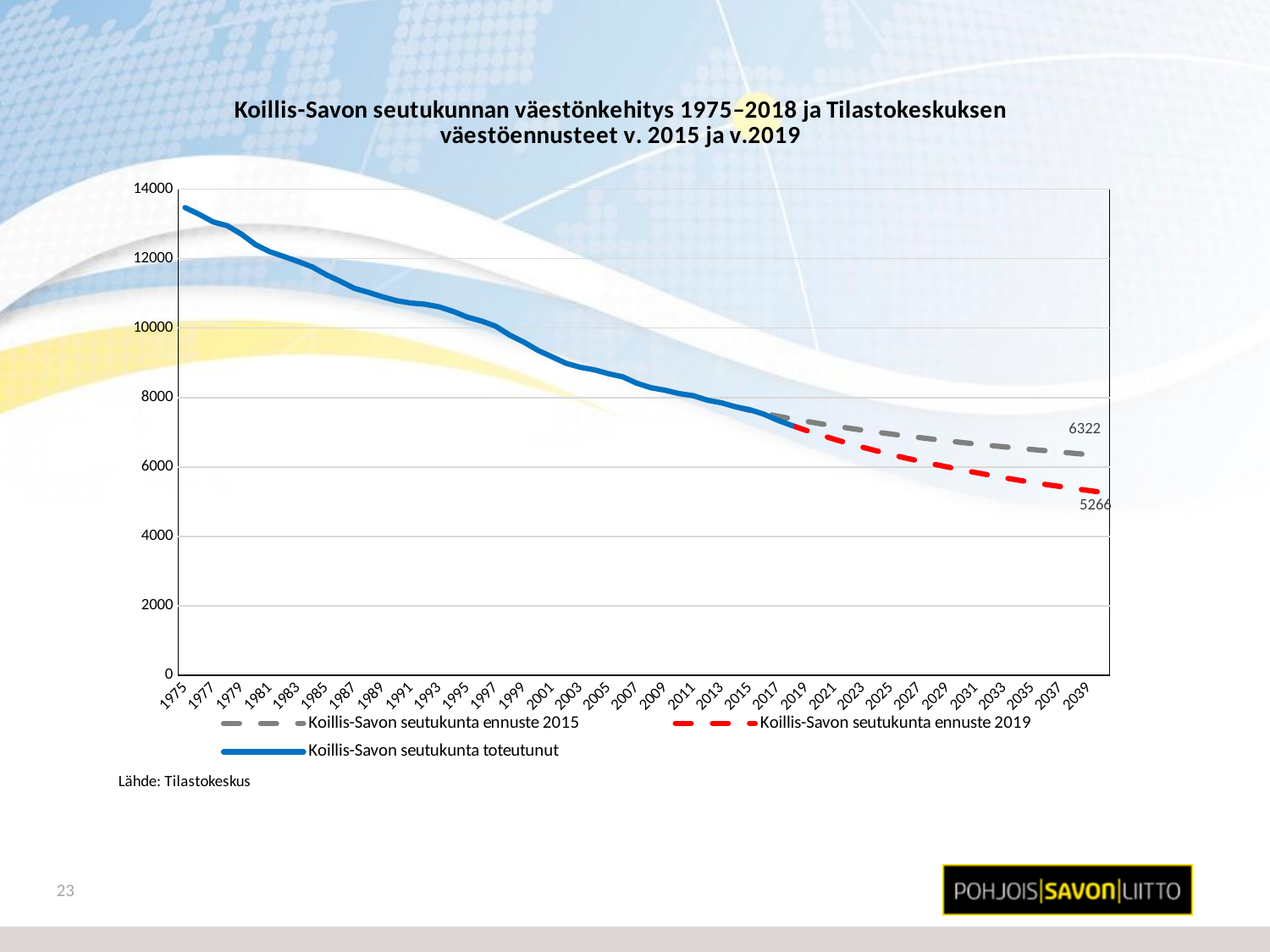
How many series does the legend list? 3 What is the final labelled value of the 'Koillis-Savon seutukunta ennuste 2015' series? 6322 Is the value of the 'toteutunut' series in 1985 greater or less than 10000? greater Is the value of the 'toteutunut' series in 2015 greater or less than 8000? less Does the 'Koillis-Savon seutukunta toteutunut' series rise or fall from 1975 to 2018? fall What is the final labelled value of the 'Koillis-Savon seutukunta ennuste 2019' series? 5266 What colour is the 'Koillis-Savon seutukunta toteutunut' line? blue Is the value of the 'toteutunut' series in 1975 greater or less than 12000? greater Which forecast series ends at a higher value, ennuste 2015 or ennuste 2019? Koillis-Savon seutukunta ennuste 2015 What kind of chart is shown on the slide? line chart What source is cited below the chart? Tilastokeskus What is the difference between the final labelled values of the 2015 forecast (6322) and the 2019 forecast (5266)? 1056